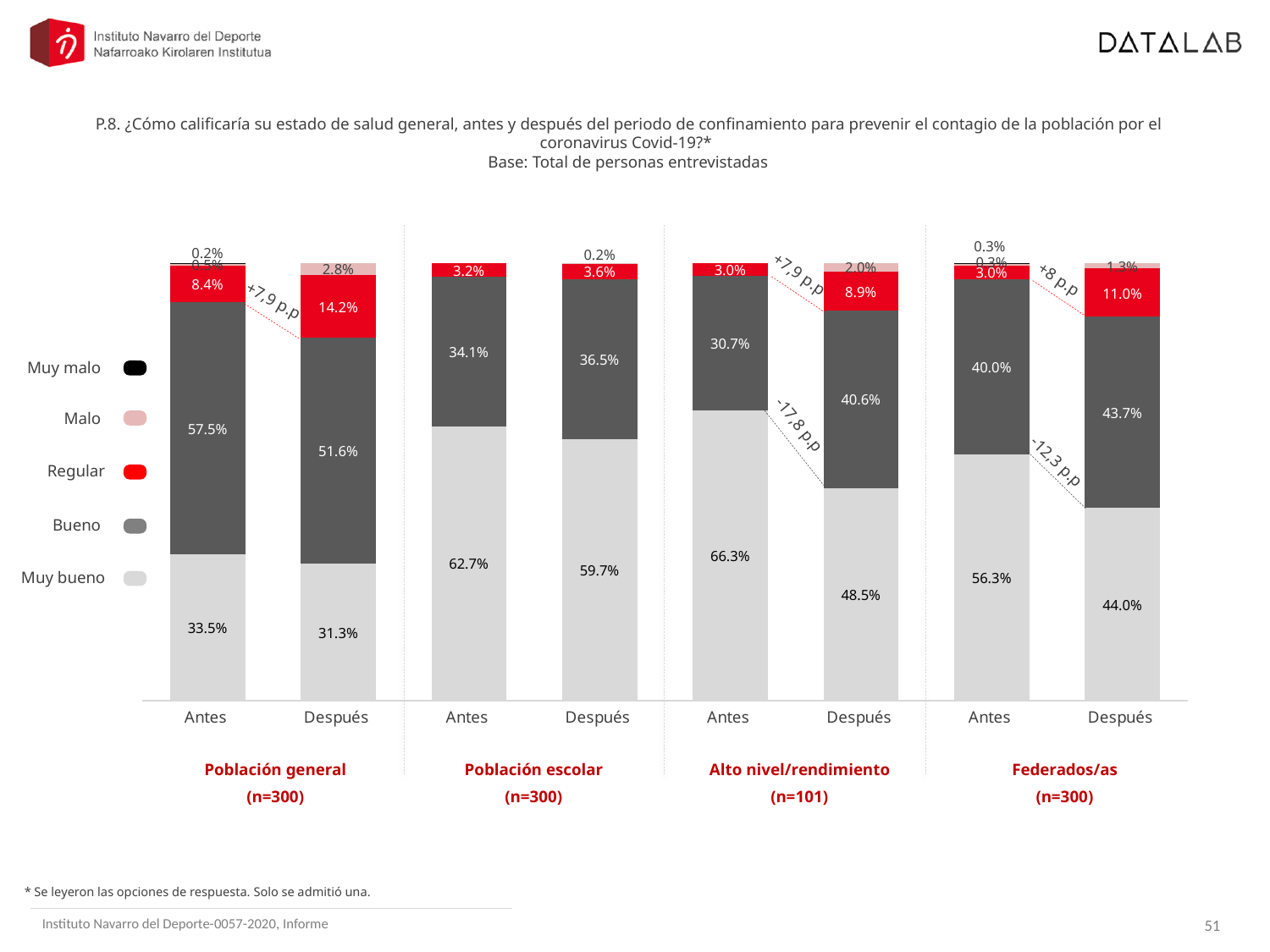
Which is larger in the Población escolar group: the "Muy bueno" value for "Antes" or for "Después"? Antes How many population groups are shown on the chart? 4 What kind of chart is shown on the slide? Stacked bar chart What is the sample size (n) shown for the Alto nivel/rendimiento group? n=101 Which group has the highest "Muy bueno" value in its "Antes" bar? Alto nivel/rendimiento What is the value for "Regular" in the "Después" bar of the Federados/as group? 11.0% What is the value for "Bueno" in the "Después" bar of the Población escolar group? 36.5% How many series does the legend list? 5 What is the value for "Muy bueno" in the "Antes" bar of the Población general group? 33.5% What is the value for "Muy bueno" in the "Después" bar of the Alto nivel/rendimiento group? 48.5% What is the value for "Regular" in the "Después" bar of the Población general group? 14.2% What is the difference between the "Muy bueno" values for "Antes" and "Después" in the Federados/as group? 12.3 percentage points